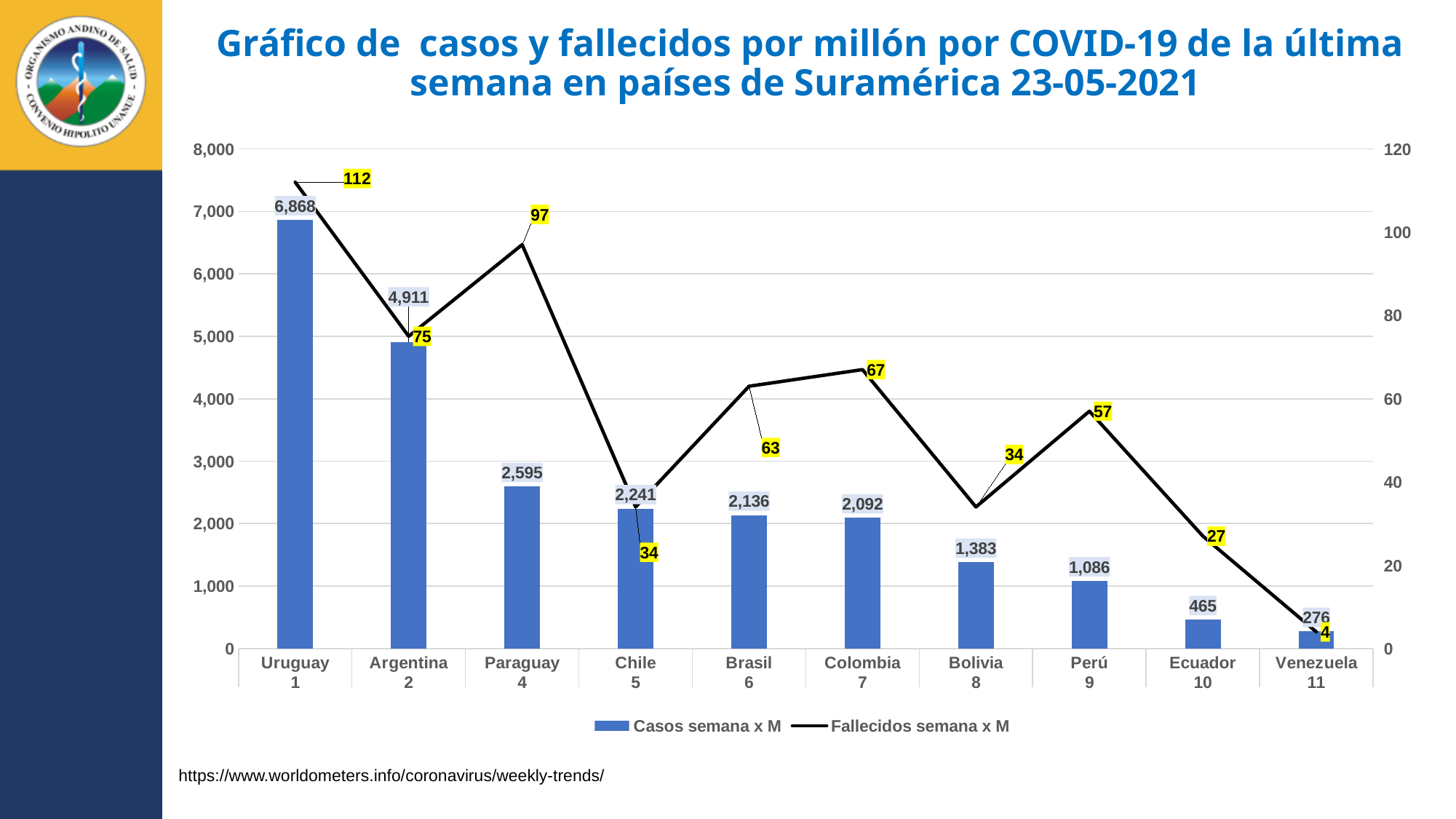
What is the value of Fallecidos semana x M for Venezuela? 4 How many series does the legend list? 2 Do the Casos semana x M values rise or fall from Uruguay to Venezuela along the x axis? Fall Which country has the lowest value of Fallecidos semana x M? Venezuela What kind of chart is used for the Casos semana x M series? Bar chart What is the difference between the Casos semana x M values for Uruguay and Argentina? 1,957 What is the value of Fallecidos semana x M for Paraguay? 97 What is the value of Casos semana x M for Bolivia? 1,383 Which has a higher Fallecidos semana x M value, Brasil or Colombia? Colombia Which country has the highest value of Casos semana x M? Uruguay How many countries are shown on the x axis? 10 What is the value of Casos semana x M for Uruguay? 6,868